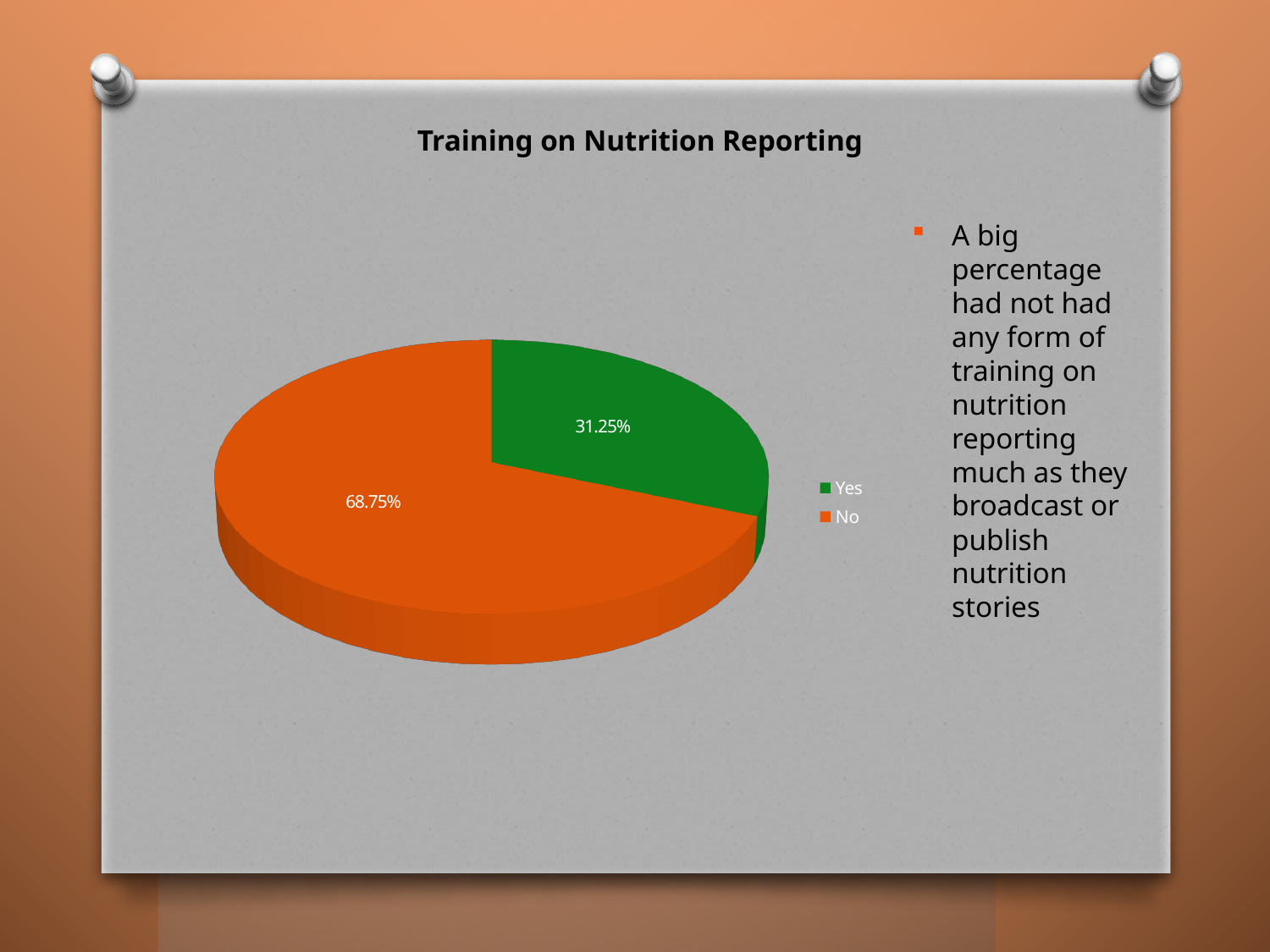
Which category has the largest share of the pie? No Which is larger, the "Yes" slice or the "No" slice? No What kind of chart is shown on the slide? pie chart What colour is the "No" slice? orange What is the title of the chart? Training on Nutrition Reporting What is the share of the pie taken by the "Yes" slice? 31.25% What is the difference between the "No" share and the "Yes" share? 37.5% How many categories does the pie chart show? 2 How many entries does the legend list? 2 Which category has the smallest share of the pie? Yes What percentage of the pie is labelled "No"? 68.75% What percentage of the pie is labelled "Yes"? 31.25%